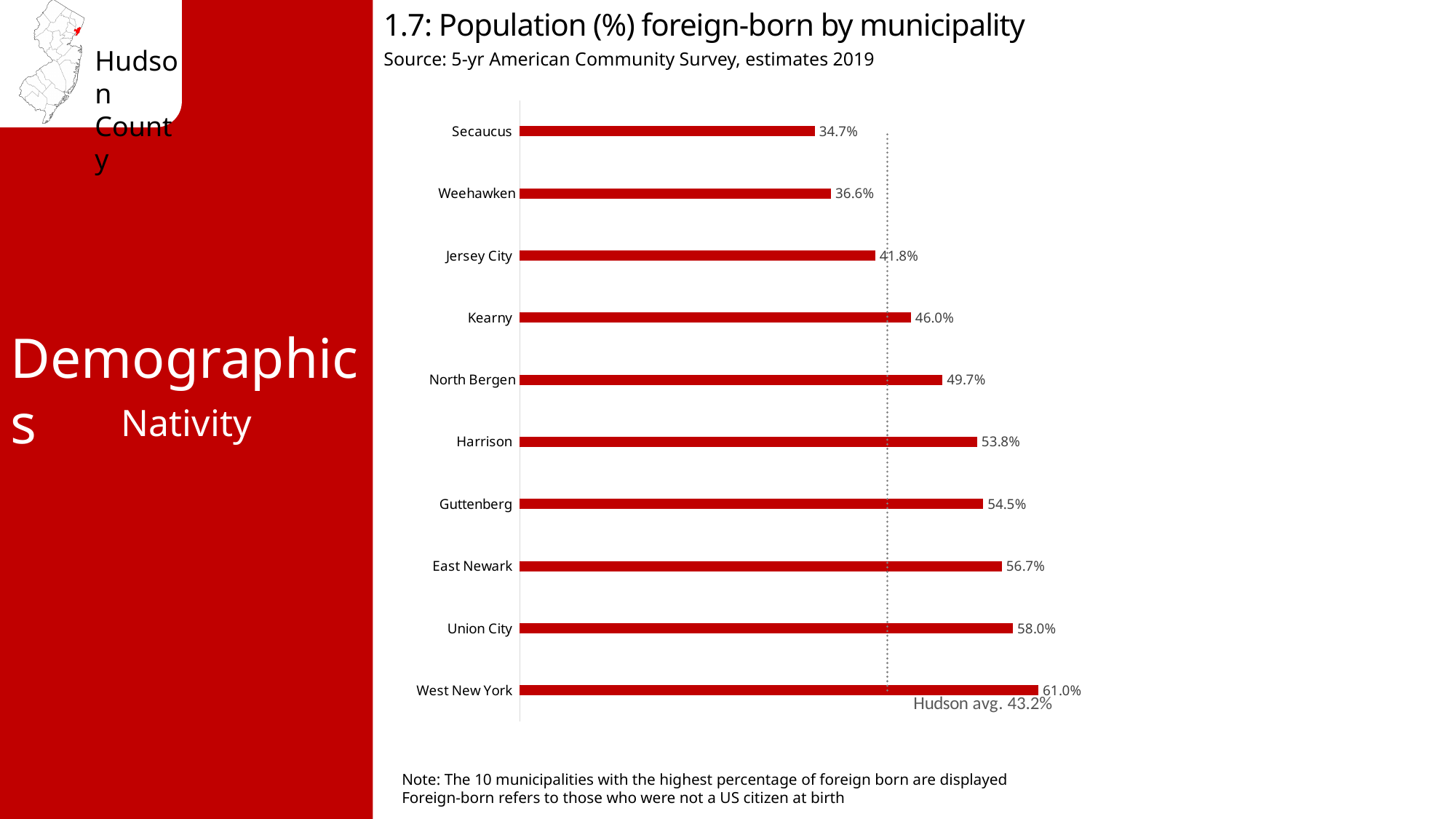
What is the source of the data shown in the chart? 5-yr American Community Survey, estimates 2019 How many municipalities are shown on the chart? 10 Which municipality has the lowest percentage of foreign-born population on the chart? Secaucus What is the Hudson County average foreign-born percentage indicated by the dotted line? 43.2% What is the difference in foreign-born percentage between West New York and Secaucus? 26.3% What type of chart is used to show the foreign-born population by municipality? Bar chart What is the difference in foreign-born percentage between Union City and North Bergen? 8.3% Which has a higher foreign-born percentage, Harrison or Weehawken? Harrison What is the foreign-born percentage shown for Kearny? 46.0% Which municipality has the highest percentage of foreign-born population? West New York What percentage of the population is foreign-born in Jersey City? 41.8% What is the foreign-born percentage shown for Guttenberg? 54.5%